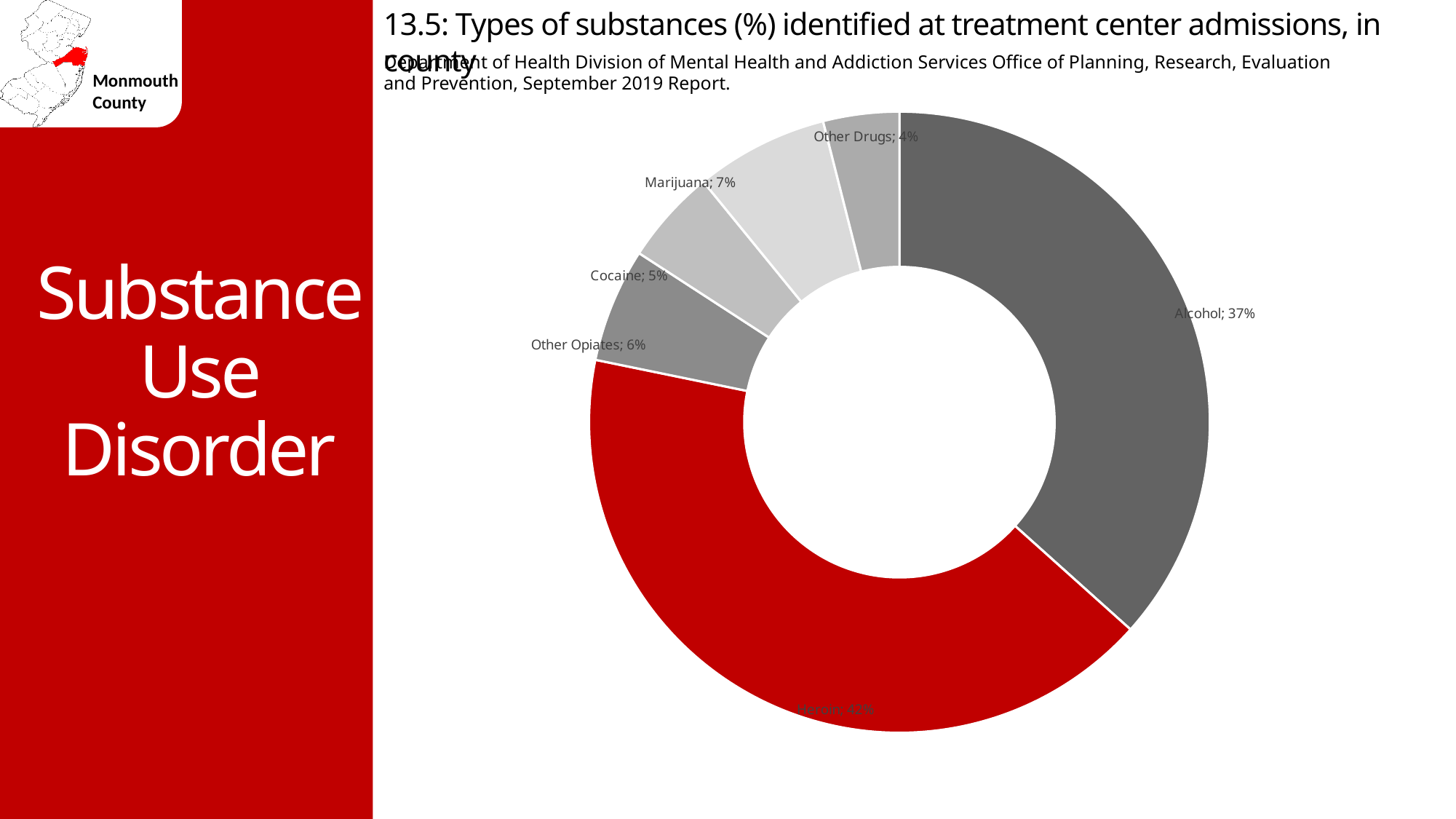
Which substance has the smallest share of admissions? Other Drugs Which substance has the largest share of admissions? Heroin What is the value shown for Other Opiates? 6% What percentage of treatment center admissions identified Heroin? 42% Which slice of the chart is coloured red? Heroin Which is larger, the share for Cocaine or the share for Marijuana? Marijuana What is the difference in percentage points between Other Opiates and Other Drugs? 2 How many substance categories are shown in the chart? 6 What is the difference in percentage points between Heroin and Alcohol? 5 What percentage of treatment center admissions identified Alcohol? 37% What is the value shown for Marijuana? 7% What kind of chart is shown on the slide? Doughnut chart